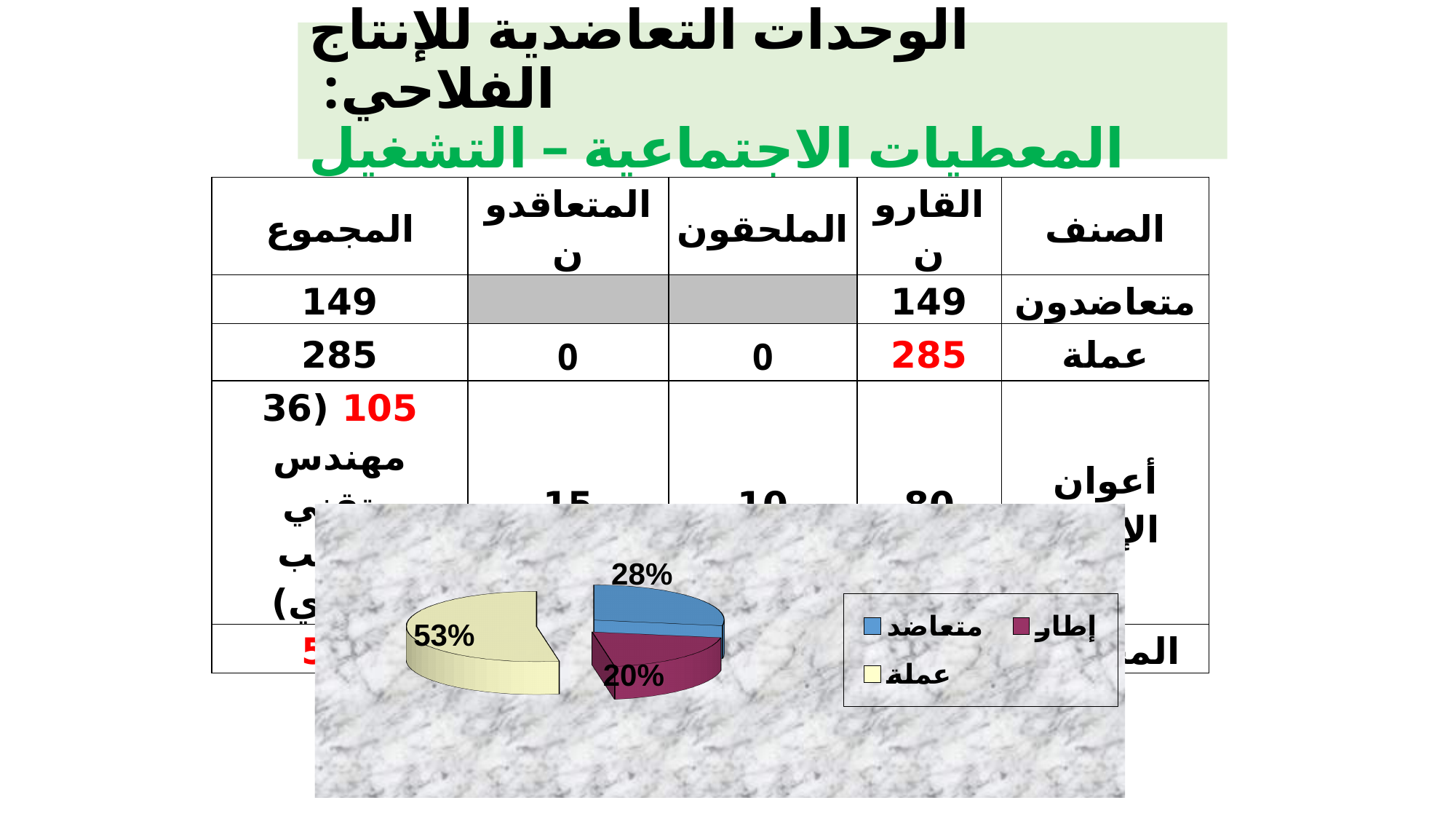
What share of the pie chart does the إطار slice represent? 20% What kind of chart is shown on the slide? pie chart What colour is the عملة slice in the pie chart? cream (pale yellow) What share of the pie chart does the عملة slice represent? 53% Which category has the smallest slice in the pie chart? إطار What share of the pie chart does the متعاضد slice represent? 28% Which slice is larger in the pie chart, متعاضد or إطار? متعاضد Which category has the largest slice in the pie chart? عملة How many slices does the pie chart have? 3 How many entries does the legend of the pie chart list? 3 By how many percentage points does the عملة slice exceed the متعاضد slice? 25 By how many percentage points does the متعاضد slice exceed the إطار slice? 8